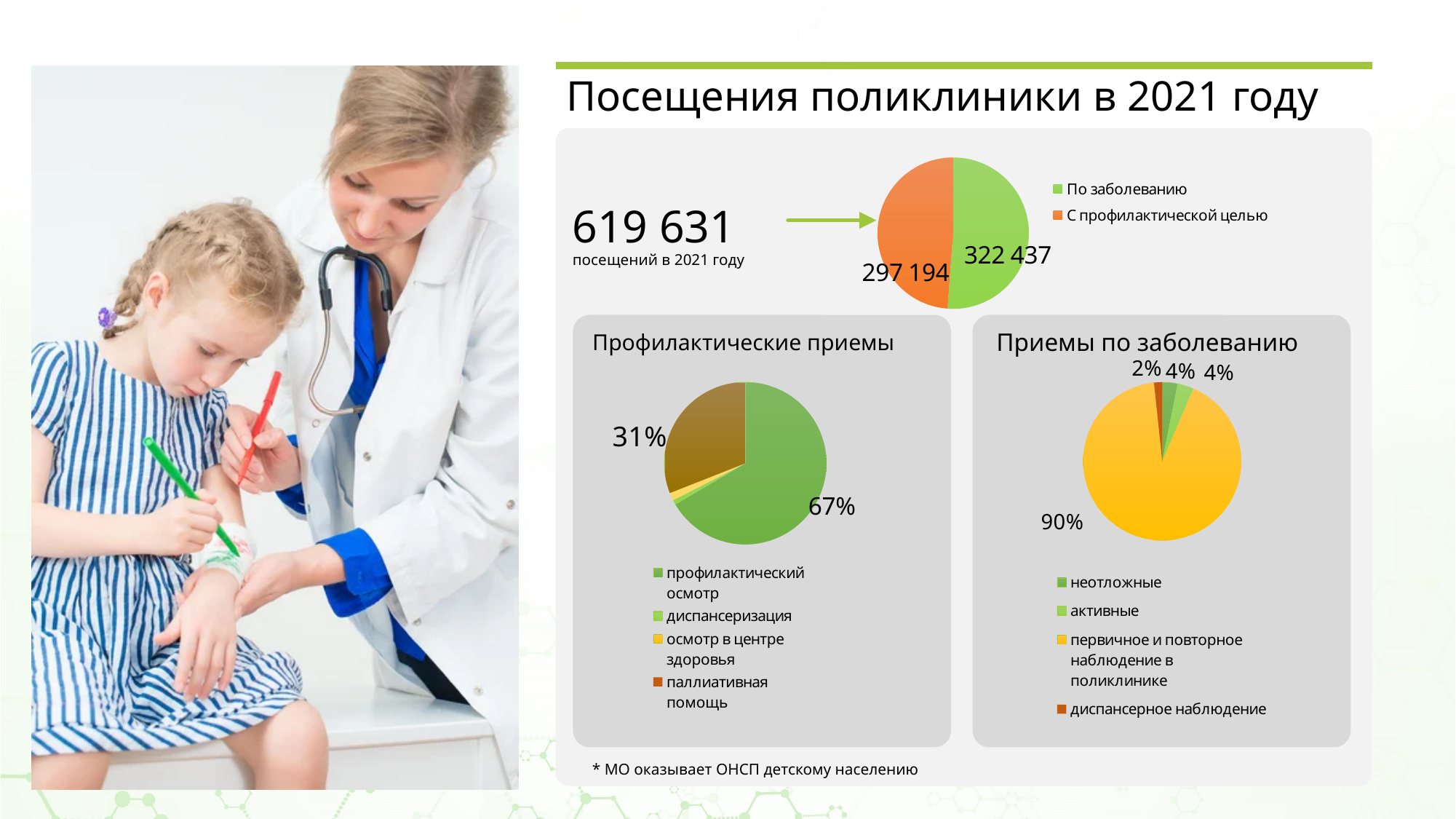
In the «Профилактические приемы» chart, which category has the largest slice? профилактический осмотр In the top pie chart, how many visits are shown for «С профилактической целью»? 297 194 What type of chart is used for «Приемы по заболеванию»? pie chart In the «Профилактические приемы» chart, what share is labeled for «профилактический осмотр»? 67% What is the total number of visits in 2021 shown next to the top pie chart? 619 631 In the top pie chart, which category has more visits: «По заболеванию» or «С профилактической целью»? По заболеванию In the «Приемы по заболеванию» chart, which category has the largest slice? первичное и повторное наблюдение в поликлинике How many categories does the legend of the «Профилактические приемы» chart list? 4 How many categories does the legend of the top pie chart list? 2 In the «Приемы по заболеванию» chart, what share is labeled for «первичное и повторное наблюдение в поликлинике»? 90% In the top pie chart, how many visits are shown for «По заболеванию»? 322 437 In the top pie chart, what is the difference between the visits «По заболеванию» and «С профилактической целью»? 25 243